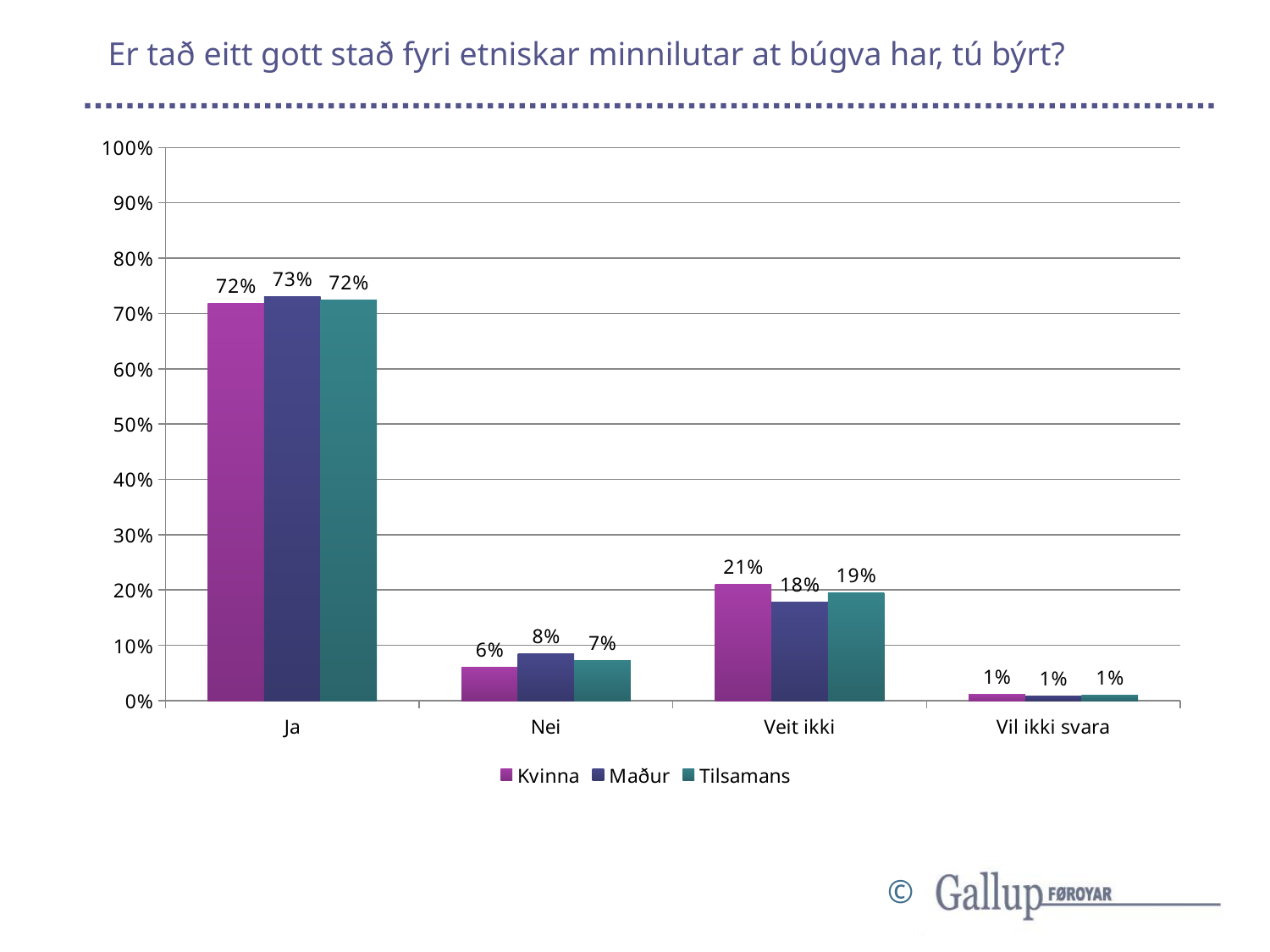
Which category has the lowest value for Maður? Vil ikki svara How many series does the legend list? 3 How many categories are shown on the x axis? 4 Which category has the highest value for Tilsamans? Ja In the Nei category, which is larger: the Kvinna value or the Maður value? Maður What is the value for Tilsamans in the Veit ikki category? 19% What is the value for Kvinna in the Ja category? 72% Is the value for Maður in the Ja category greater or less than 70%? greater What kind of chart is shown on the slide? Bar chart What is the value for Kvinna in the Vil ikki svara category? 1% What is the value for Maður in the Nei category? 8% What is the difference between the Kvinna and Maður values in the Veit ikki category? 3%